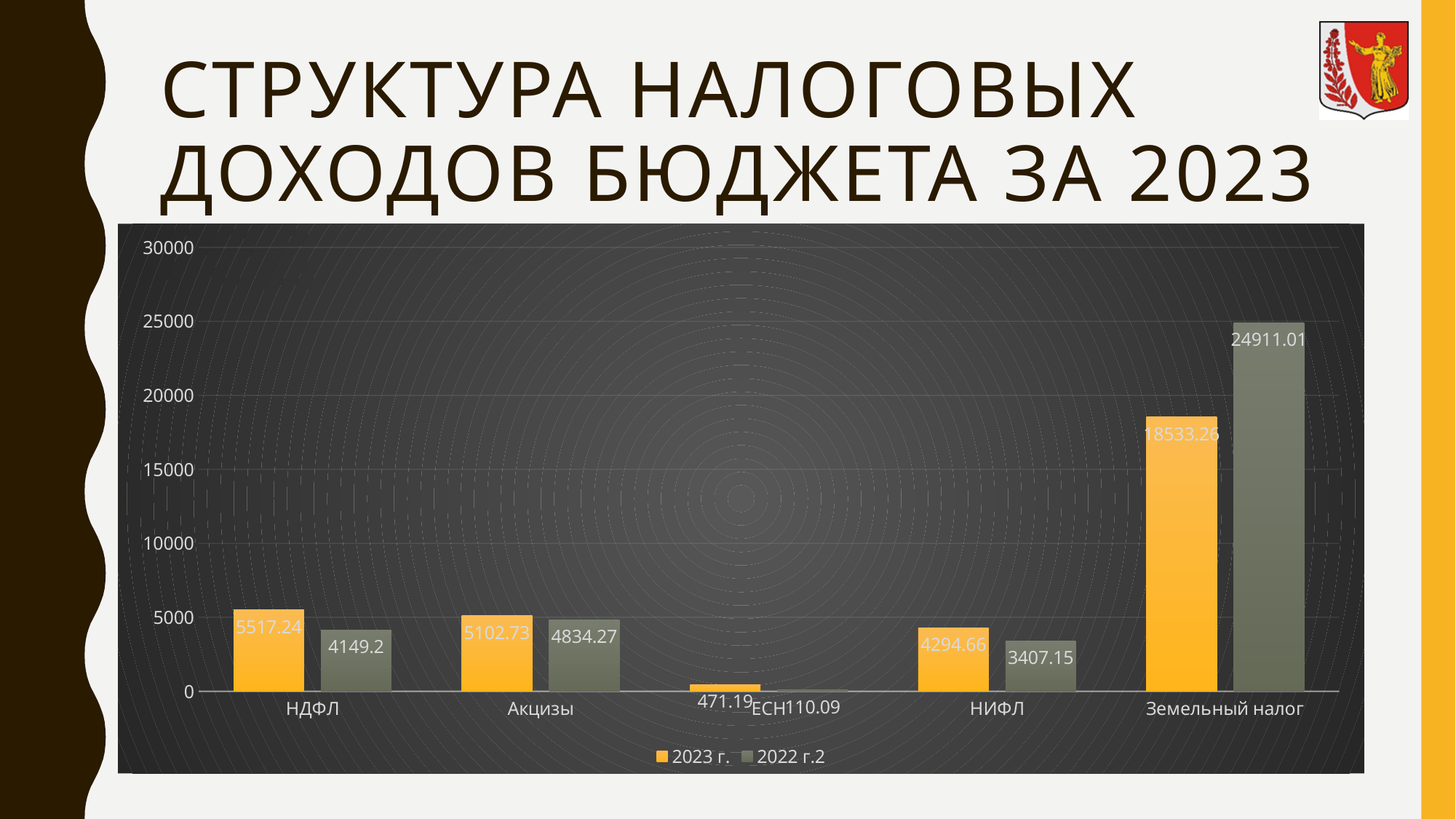
What is the value for Земельный налог in the 2022 г.2 series? 24911.01 How many series does the legend list? 2 What is the value for Акцизы in the 2022 г.2 series? 4834.27 What kind of chart is shown on the slide? bar chart What is the value for НИФЛ in the 2023 г. series? 4294.66 Which category has the highest value in the 2023 г. series? Земельный налог How many categories are shown on the x axis? 5 What is the value for НДФЛ in the 2023 г. series? 5517.24 Which is larger for НДФЛ: the 2023 г. value or the 2022 г.2 value? 2023 г. What is the difference between the 2022 г.2 and 2023 г. values for Земельный налог? 6377.75 Is the 2023 г. value for Земельный налог greater or less than 15000? greater Which category has the lowest value in the 2022 г.2 series? ЕСН